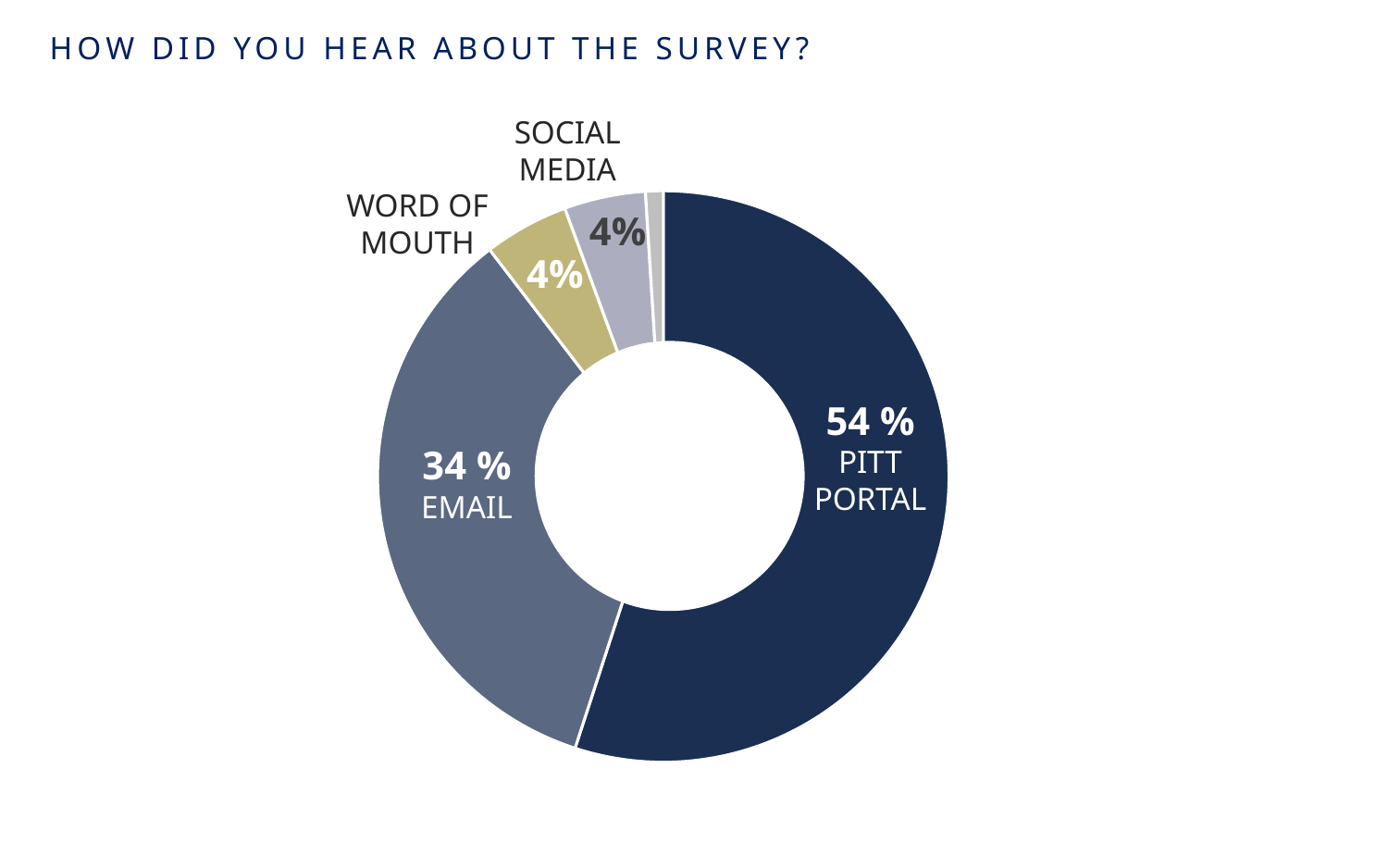
What percentage of respondents heard about the survey through the Pitt Portal? 54 % What is the title of the chart? How did you hear about the survey? Which source has the largest share of the chart? Pitt Portal What percentage of respondents heard about the survey through word of mouth? 4% What percentage of respondents heard about the survey through email? 34 % What percentage of respondents heard about the survey through social media? 4% Is the share for Pitt Portal greater or less than 50%? greater Which slice of the chart is coloured gold/khaki? Word of Mouth What kind of chart is shown on the slide? pie (donut) chart Which is larger, the share for Pitt Portal or the share for Email? Pitt Portal What is the difference in percentage points between the Pitt Portal share and the Email share? 20 % Is the share for Email greater or less than 50%? less